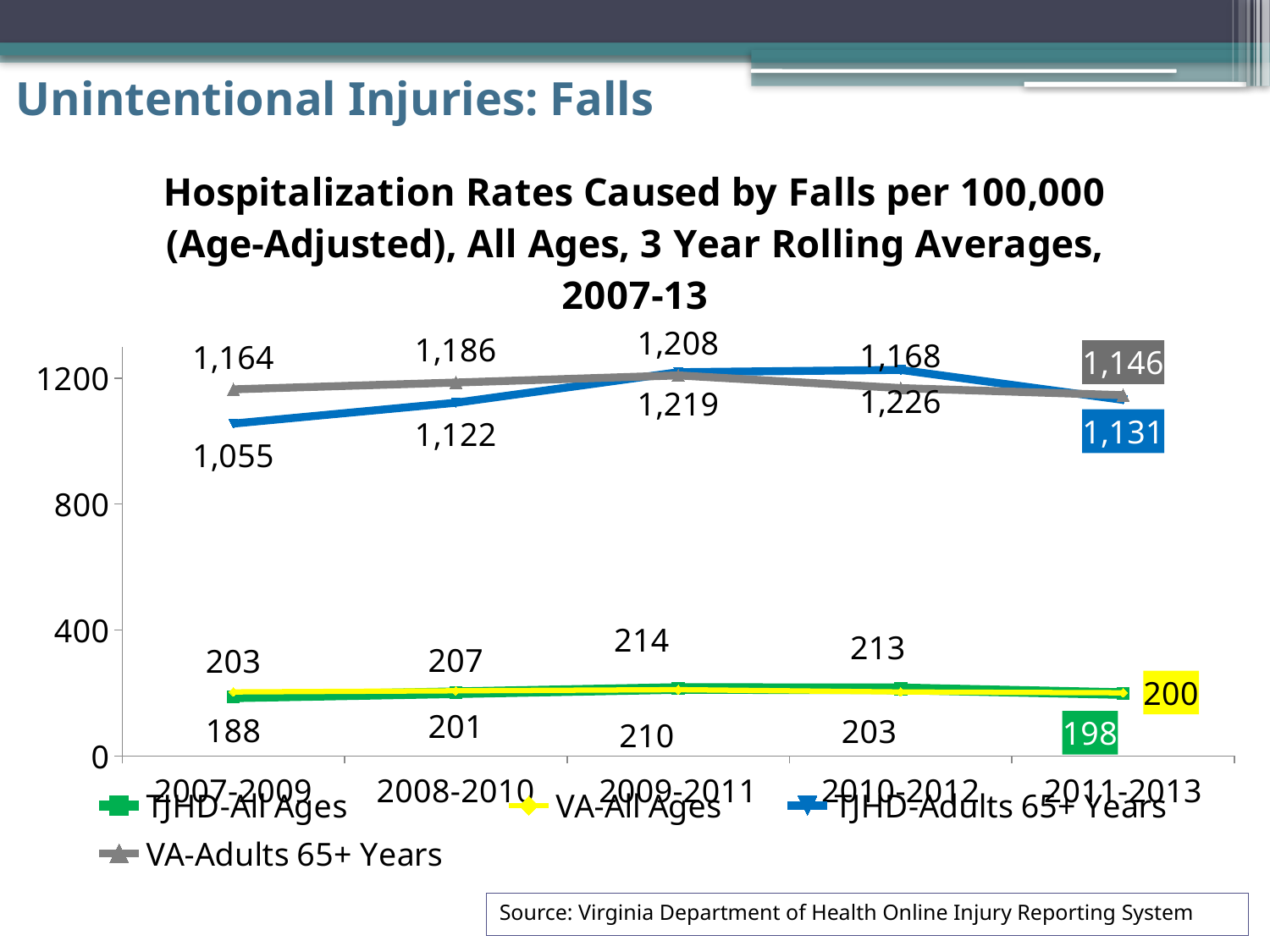
What kind of chart is shown on the slide? line chart What is the value for VA-Adults 65+ Years in 2011-2013? 1,146 What is the value for TJHD-All Ages in 2011-2013? 198 What is the value for TJHD-Adults 65+ Years in 2011-2013? 1,131 What is the value for VA-All Ages in 2011-2013? 200 How many time periods are plotted along the x axis? 5 What is the value for TJHD-Adults 65+ Years in 2007-2009? 1,055 How many series does the legend list? 4 In 2007-2009, which is higher: VA-Adults 65+ Years or TJHD-Adults 65+ Years? VA-Adults 65+ Years What is the difference between VA-Adults 65+ Years and TJHD-Adults 65+ Years in 2007-2009? 109 In which period is the TJHD-Adults 65+ Years rate highest? 2010-2012 Is the value for TJHD-All Ages in 2009-2011 greater or less than 400? less